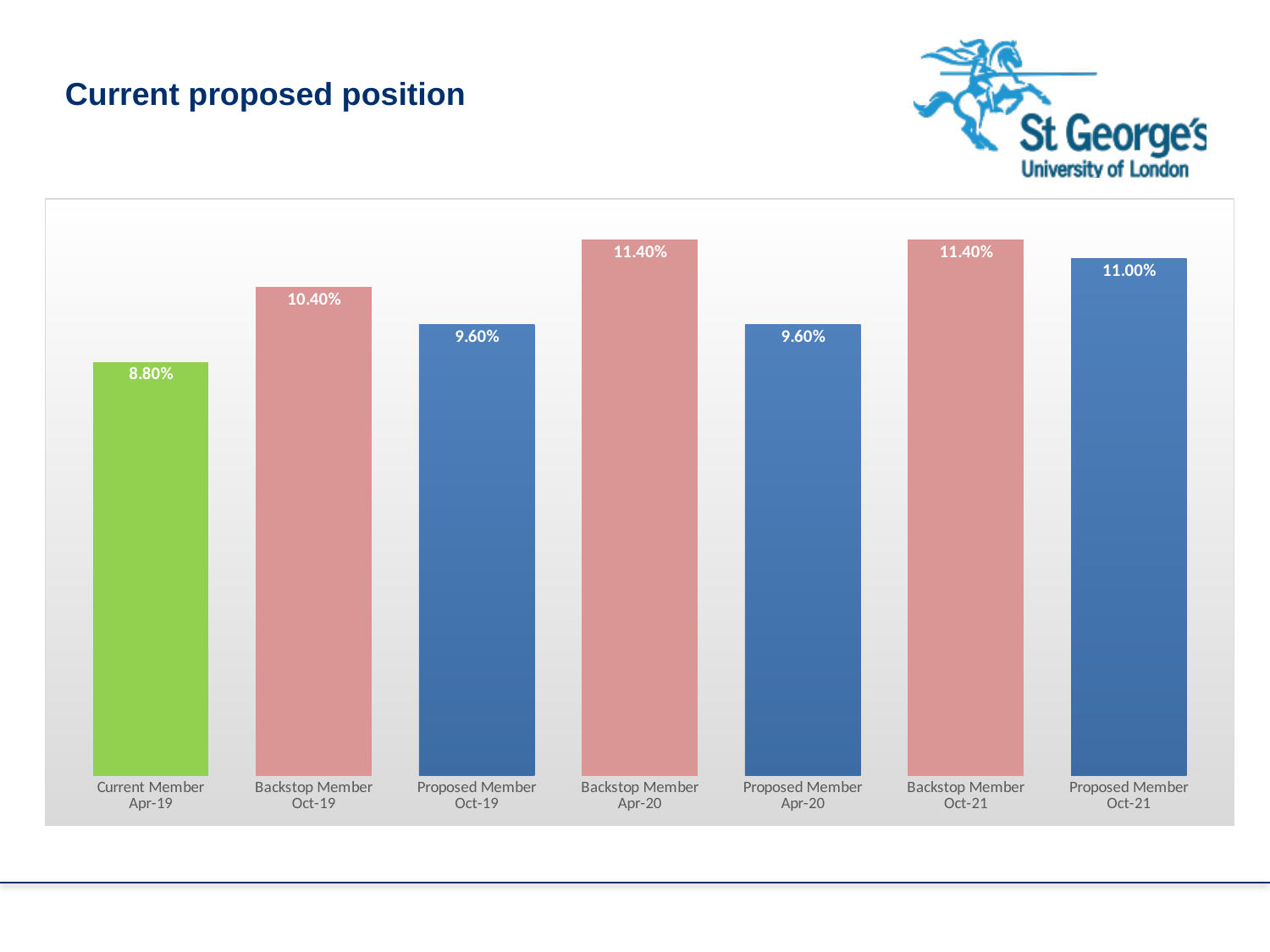
What is the difference between Backstop Member Apr-20 and Proposed Member Apr-20? 1.80% Which is larger, Backstop Member Oct-19 or Proposed Member Oct-19? Backstop Member Oct-19 What kind of chart is shown on the slide? Bar chart Which category has the lowest value? Current Member Apr-19 What is the value for Proposed Member Apr-20? 9.60% Which is larger, Proposed Member Oct-21 or Backstop Member Oct-21? Backstop Member Oct-21 What is the difference between Proposed Member Oct-21 and Current Member Apr-19? 2.20% What is the value for Proposed Member Oct-21? 11.00% How many bars are shown in the chart? 7 What colour is the bar for Current Member Apr-19? Green What is the value for Current Member Apr-19? 8.80% What is the value for Backstop Member Oct-19? 10.40%